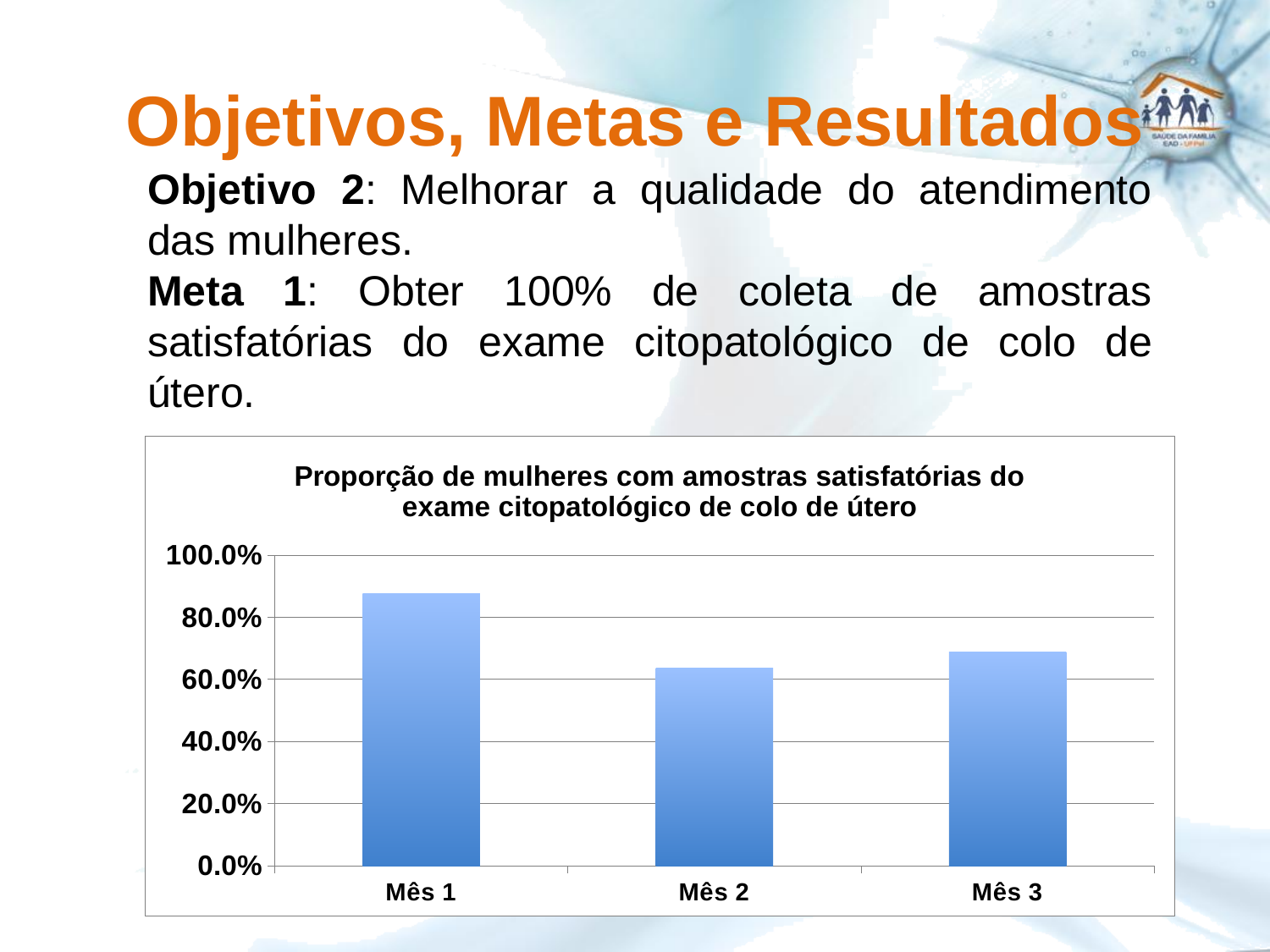
What is the highest value shown on the vertical axis of the chart? 100.0% Is the value for Mês 2 greater or less than 80.0%? less How many months (categories) are plotted on the chart? 3 Does the value fall or rise from Mês 1 to Mês 2? fall What is the title of the chart? Proporção de mulheres com amostras satisfatórias do exame citopatológico de colo de útero Which is larger, the value for Mês 1 or the value for Mês 2? Mês 1 Is the value for Mês 1 greater or less than 80.0%? greater Is the value for Mês 3 greater or less than 80.0%? less Which month has the highest proportion of women with satisfactory samples? Mês 1 Which month has the lowest proportion of women with satisfactory samples? Mês 2 What kind of chart is shown on the slide? bar chart